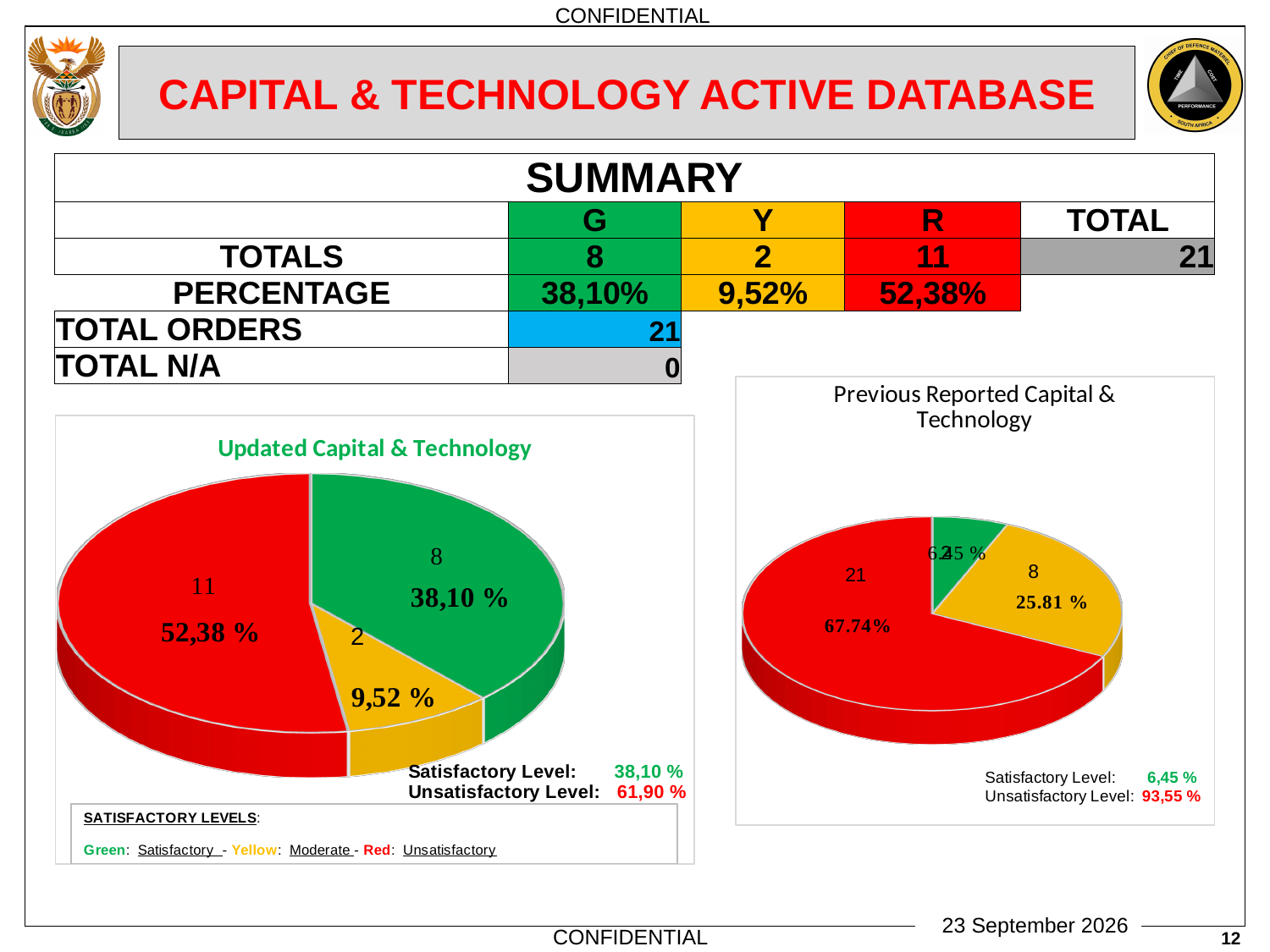
In the "Previous Reported Capital & Technology" chart, what count is shown for the yellow slice? 8 In the "Updated Capital & Technology" chart, what is the difference between the red slice count and the green slice count? 3 In the "Updated Capital & Technology" chart, what percentage is shown for the red slice? 52,38 % What kind of chart is the "Updated Capital & Technology" chart? Pie chart In the "Updated Capital & Technology" chart, how many slices does the pie have? 3 In the "Updated Capital & Technology" chart, what count is shown for the green slice? 8 In the "Updated Capital & Technology" chart, which colour slice is the largest? Red In the "Previous Reported Capital & Technology" chart, what percentage is shown for the red slice? 67.74% In the "Previous Reported Capital & Technology" chart, is the red slice or the yellow slice larger? Red In the "Updated Capital & Technology" chart, what percentage is shown for the yellow slice? 9,52 % What is the title of the pie chart on the left of the slide? Updated Capital & Technology In the "Updated Capital & Technology" chart, which colour slice is the smallest? Yellow